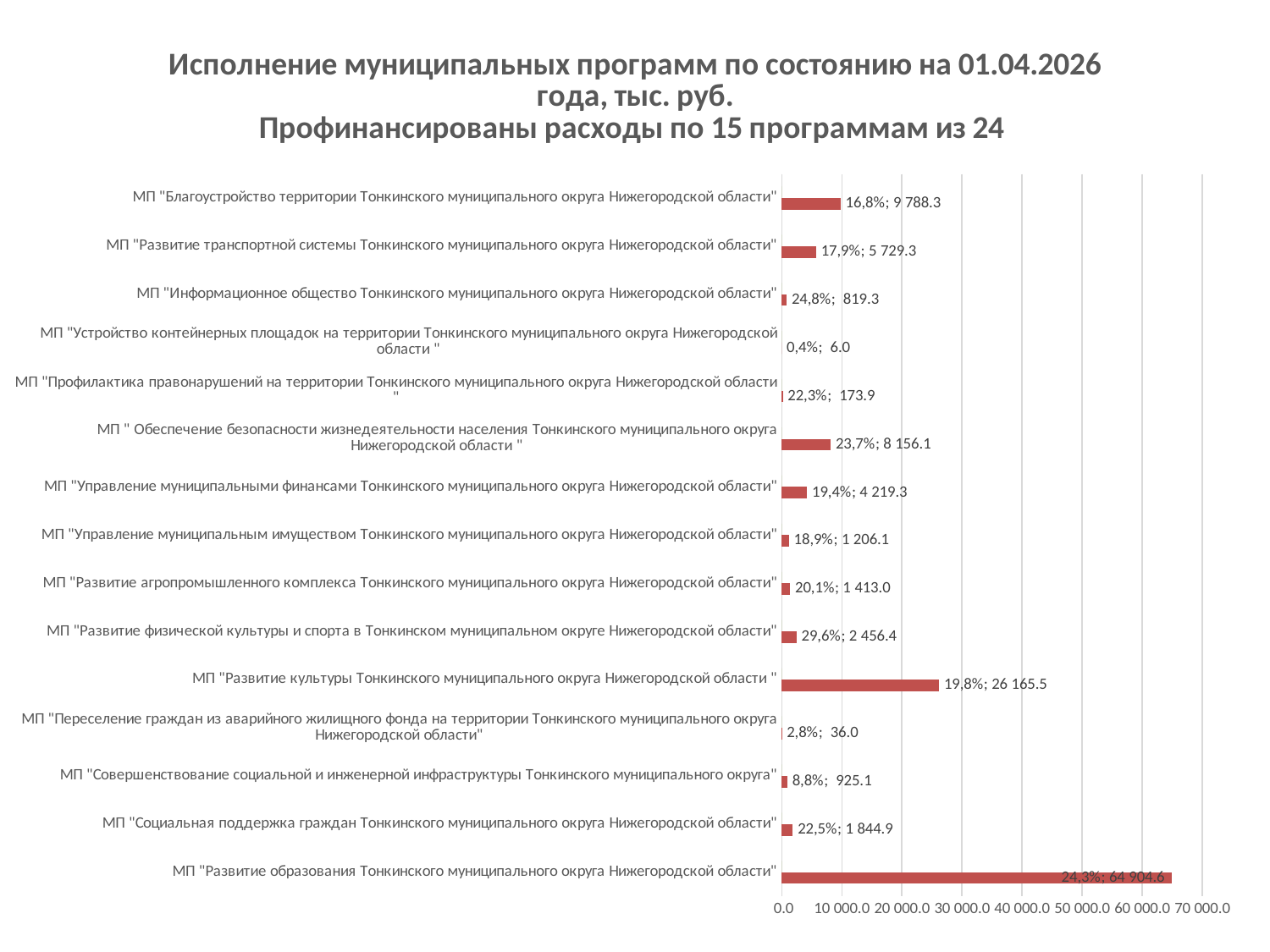
Which program has the smallest financed amount? МП "Устройство контейнерных площадок на территории Тонкинского муниципального округа Нижегородской области" Which has the larger financed amount: МП "Обеспечение безопасности жизнедеятельности населения" or МП "Управление муниципальными финансами"? МП "Обеспечение безопасности жизнедеятельности населения Тонкинского муниципального округа Нижегородской области" What is the financed amount (тыс. руб.) shown for МП "Развитие образования Тонкинского муниципального округа Нижегородской области"? 64 904.6 Is the financed amount for МП "Развитие образования" greater or less than 60 000.0? greater How many programs are shown as bars on the chart? 15 Which program has the largest financed amount? МП "Развитие образования Тонкинского муниципального округа Нижегородской области" What is the financed amount shown for МП "Развитие культуры Тонкинского муниципального округа Нижегородской области"? 26 165.5 What type of chart is shown on the slide? bar chart What is the difference between the financed amounts for МП "Благоустройство территории" and МП "Развитие транспортной системы"? 4 059.0 What execution percentage is shown for МП "Развитие физической культуры и спорта в Тонкинском муниципальном округе Нижегородской области"? 29,6% According to the chart title, expenses were financed for how many programs out of how many? 15 out of 24 What is the difference between the financed amounts for МП "Развитие образования" and МП "Развитие культуры"? 38 739.1